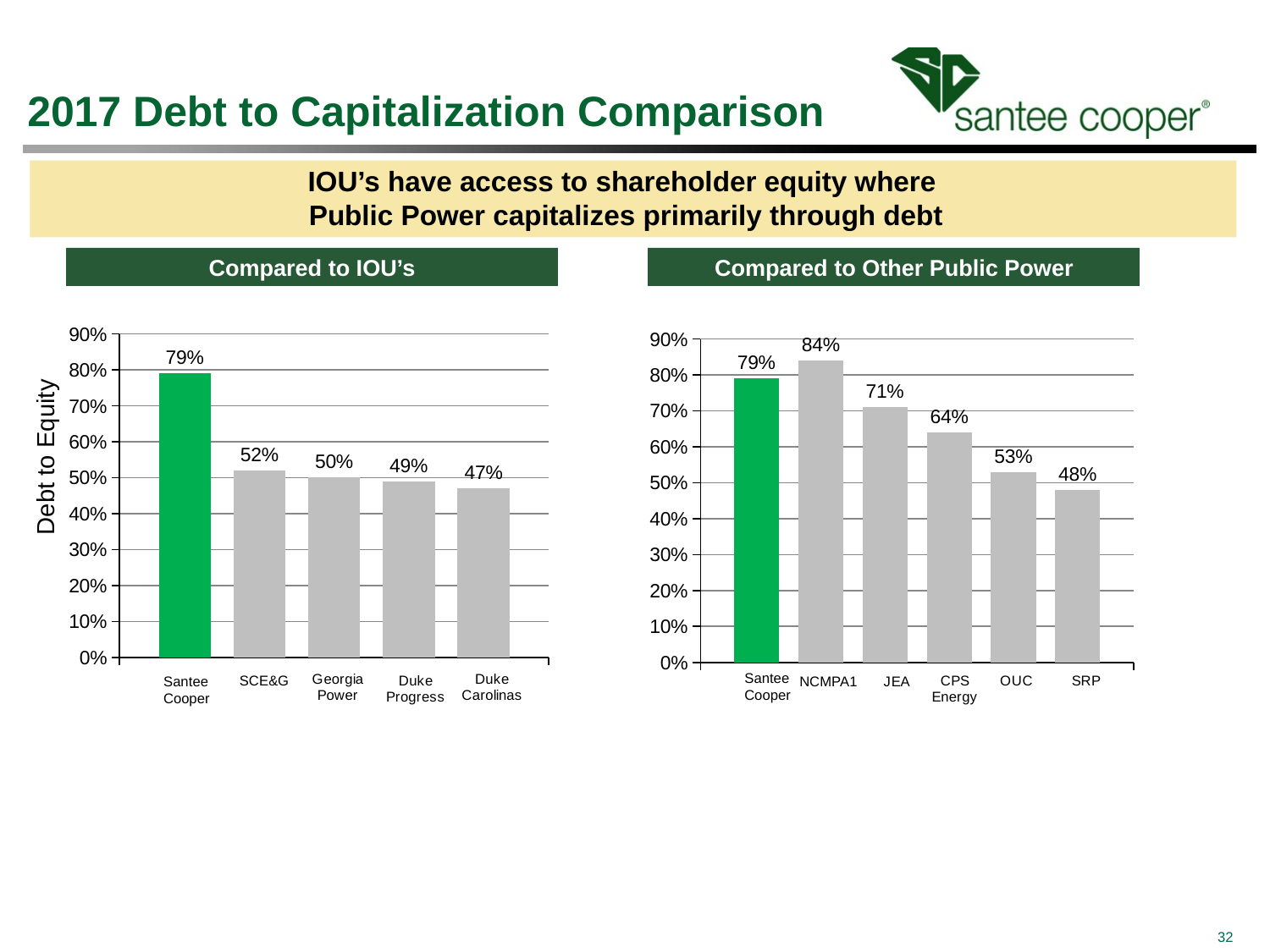
In the 'Compared to Other Public Power' chart, which bar is coloured green? Santee Cooper In the 'Compared to IOU's' chart, how many categories are shown? 5 In the 'Compared to IOU's' chart, what is the y-axis label? Debt to Equity In the 'Compared to IOU's' chart, what is the value for SCE&G? 52% In the 'Compared to Other Public Power' chart, what is the difference between CPS Energy and SRP? 16% In the 'Compared to IOU's' chart, which category has the lowest value? Duke Carolinas In the 'Compared to IOU's' chart, what is the difference between Santee Cooper and Georgia Power? 29% In the 'Compared to Other Public Power' chart, which is larger, NCMPA1 or Santee Cooper? NCMPA1 In the 'Compared to Other Public Power' chart, which category has the highest value? NCMPA1 In the 'Compared to Other Public Power' chart, how many categories are shown? 6 What kind of chart is the 'Compared to IOU's' chart? Bar chart In the 'Compared to Other Public Power' chart, what is the value for JEA? 71%